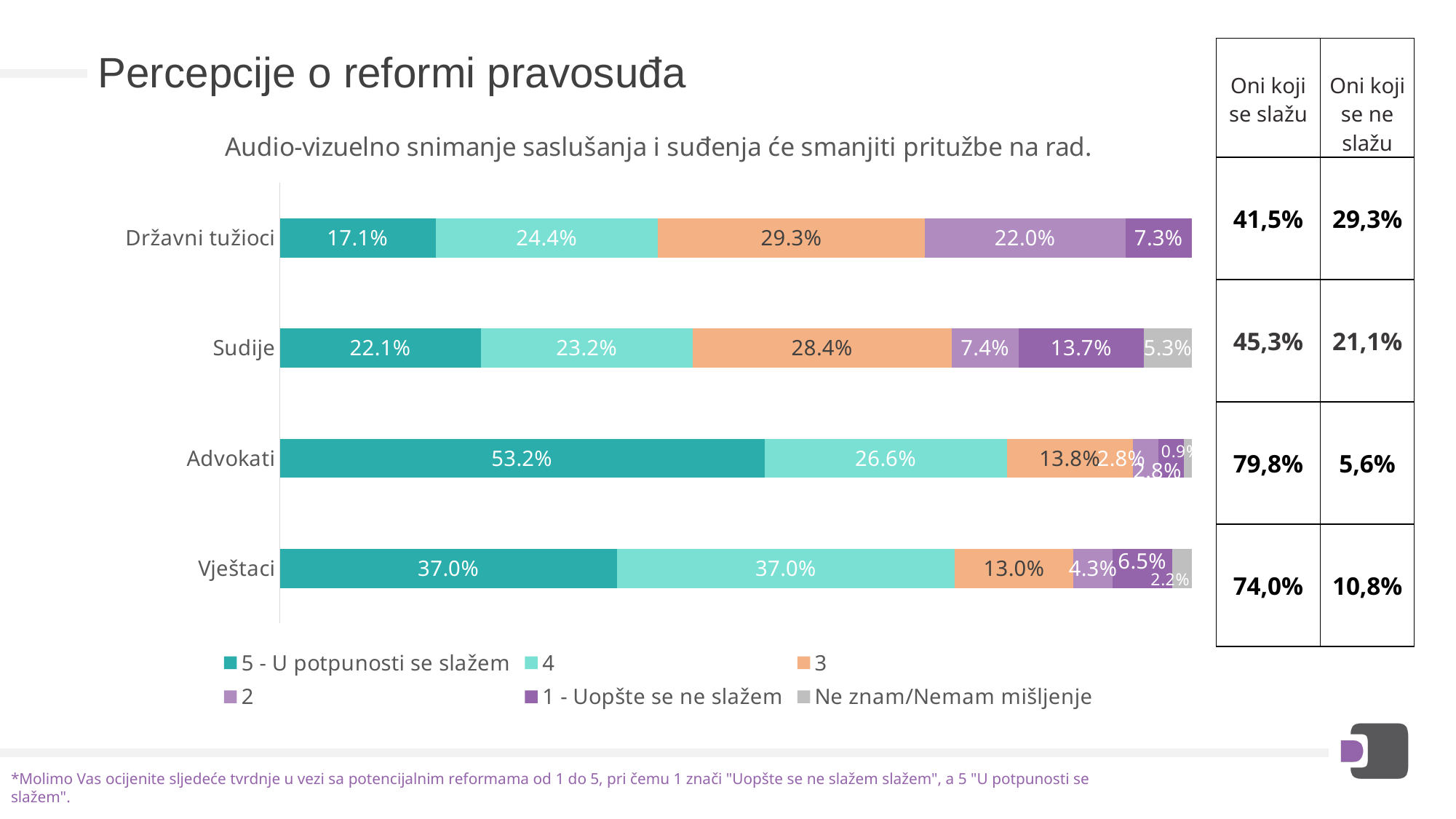
What is the value for Državni tužioci in the series "5 - U potpunosti se slažem"? 17.1% Which category has the highest value in the series "5 - U potpunosti se slažem"? Advokati Which has the larger value in the series "3": Državni tužioci or Sudije? Državni tužioci What kind of chart is shown on the slide? Stacked bar chart What is the value for Sudije in the series "3"? 28.4% How many series does the legend list? 6 How many categories are shown on the chart? 4 What is the value for Sudije in the series "1 - Uopšte se ne slažem"? 13.7% What is the value for Vještaci in the series "4"? 37.0% What is the difference between the "5 - U potpunosti se slažem" values for Sudije and Državni tužioci? 5.0% Which category has the lowest value in the series "5 - U potpunosti se slažem"? Državni tužioci What is the value for Advokati in the series "5 - U potpunosti se slažem"? 53.2%